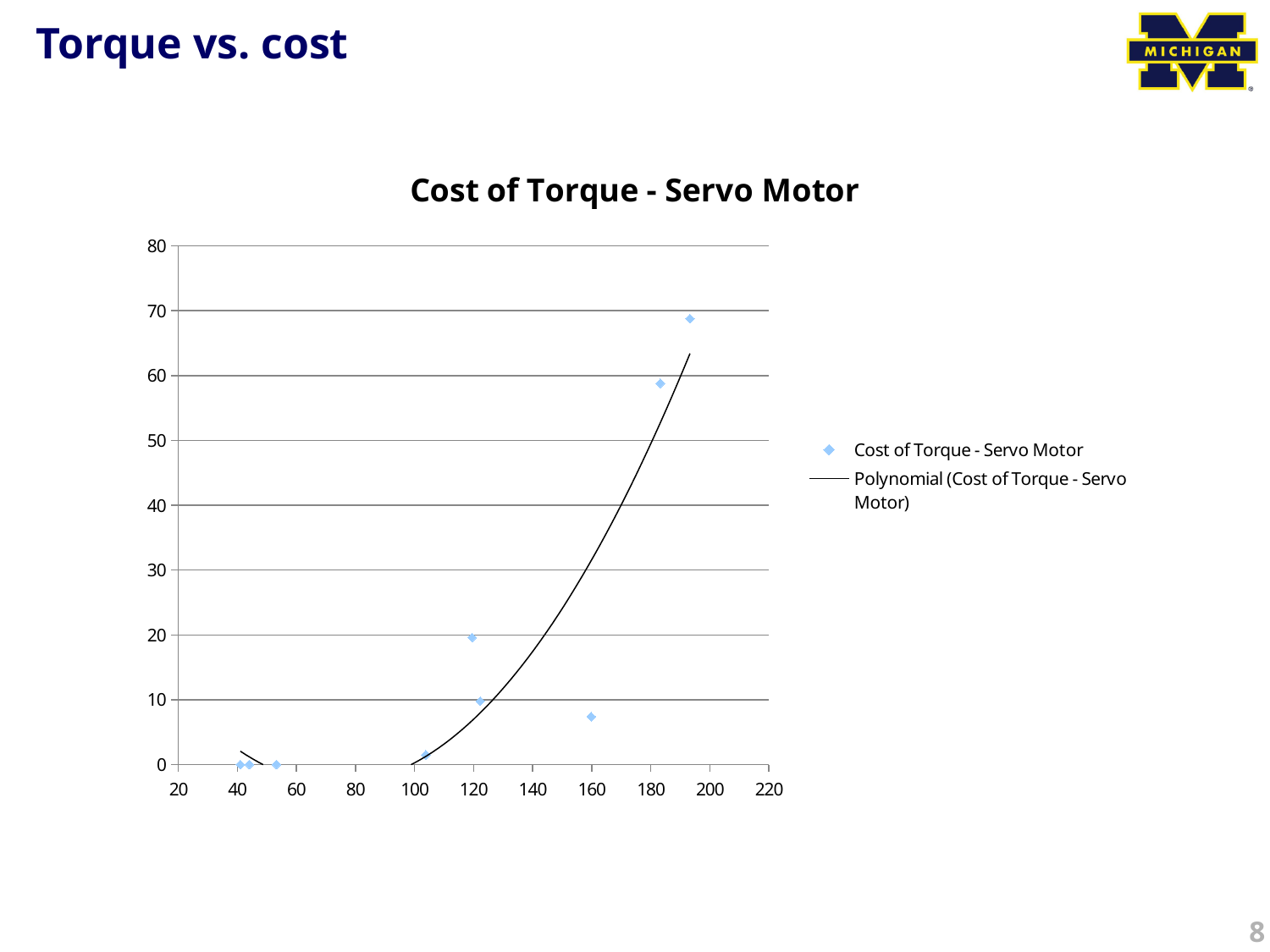
Is the value of the plotted point near x = 160 greater or less than 10? less What kind of trendline is fitted to the data according to the legend? Polynomial How many entries does the chart legend list? 2 Is the value of the highest plotted point greater or less than 60? greater What is the maximum value shown on the y axis? 80 Which plotted point is higher: the one near x = 193 or the one near x = 160? the one near x = 193 What is the title of the chart? Cost of Torque - Servo Motor Is the value of the plotted point near x = 183 greater or less than 50? greater What type of chart is shown on the slide? Scatter chart Overall, do the plotted cost values rise or fall as torque increases along the x axis? rise